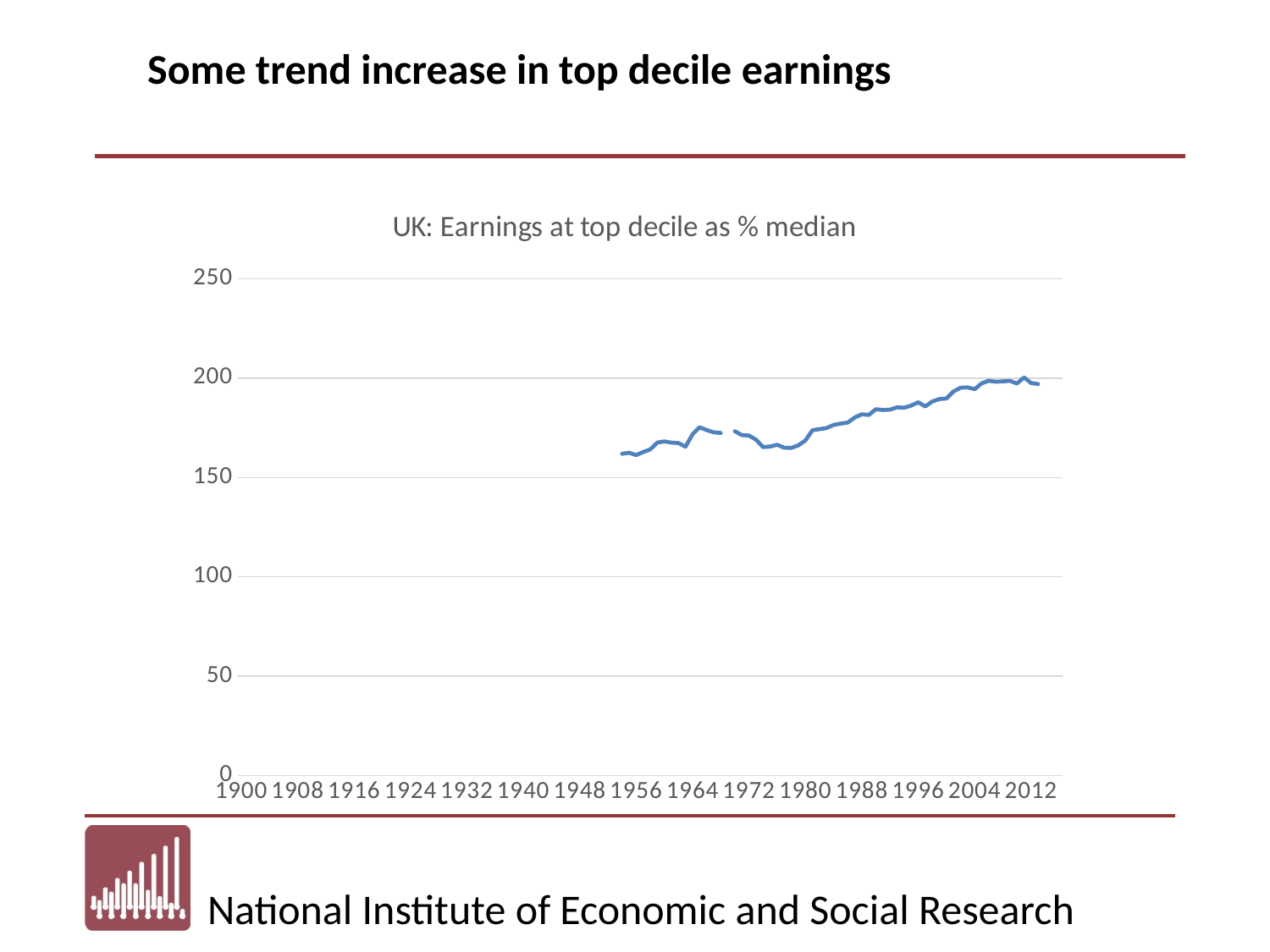
How many year labels are shown on the horizontal axis? 15 Is the value for 2004 greater or less than 250? less Is the value for 2012 greater or less than the value for 1956? greater How many lines are plotted on the chart? 1 Overall, do the plotted values rise or fall from the 1950s to 2012? rise Is the value for 1980 greater or less than 100? greater Is the value for 1976 greater or less than 200? less What is the title of the chart? UK: Earnings at top decile as % median What kind of chart is shown on the slide? line chart What is the highest value shown on the vertical axis? 250